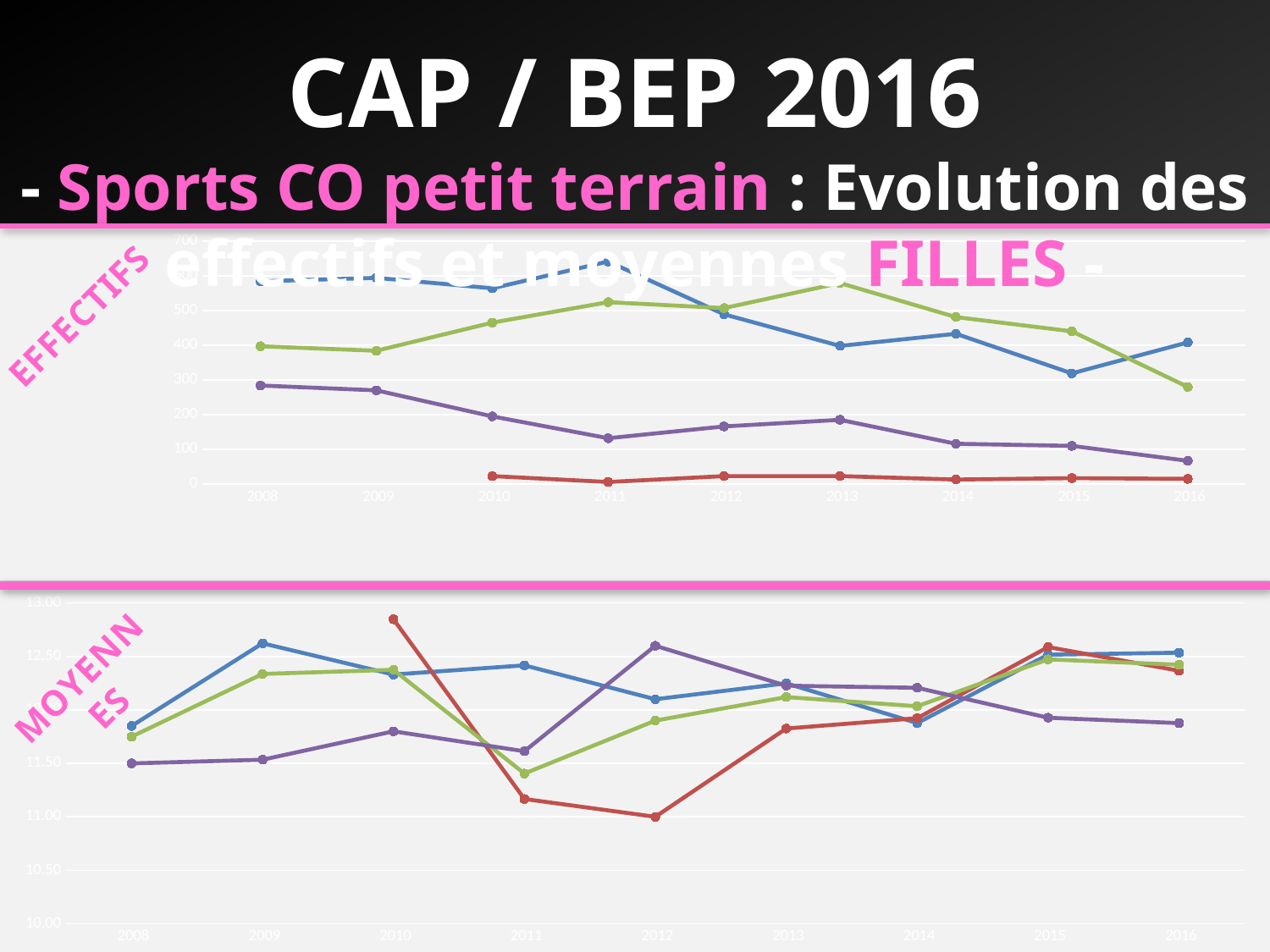
How many years are shown on the x axis of the bottom chart labelled MOYENNES? 9 In the top chart labelled EFFECTIFS, is the value of the green line in 2008 greater or less than 300? greater In the top chart labelled EFFECTIFS, is the value of the blue line in 2016 greater or less than 300? greater In the top chart labelled EFFECTIFS, in which year does the green line reach its lowest value? 2016 In the top chart labelled EFFECTIFS, does the purple line generally rise or fall from 2008 to 2016? fall In the bottom chart labelled MOYENNES, is the value of the red line in 2012 greater or less than 11.50? less In the top chart labelled EFFECTIFS, which line is higher in 2016, the blue line or the green line? the blue line In the bottom chart labelled MOYENNES, in which year does the red line reach its lowest value? 2012 What kind of chart is the top chart labelled EFFECTIFS? line chart What label is written beside the top chart? EFFECTIFS In the top chart labelled EFFECTIFS, in which year does the purple line reach its highest value? 2008